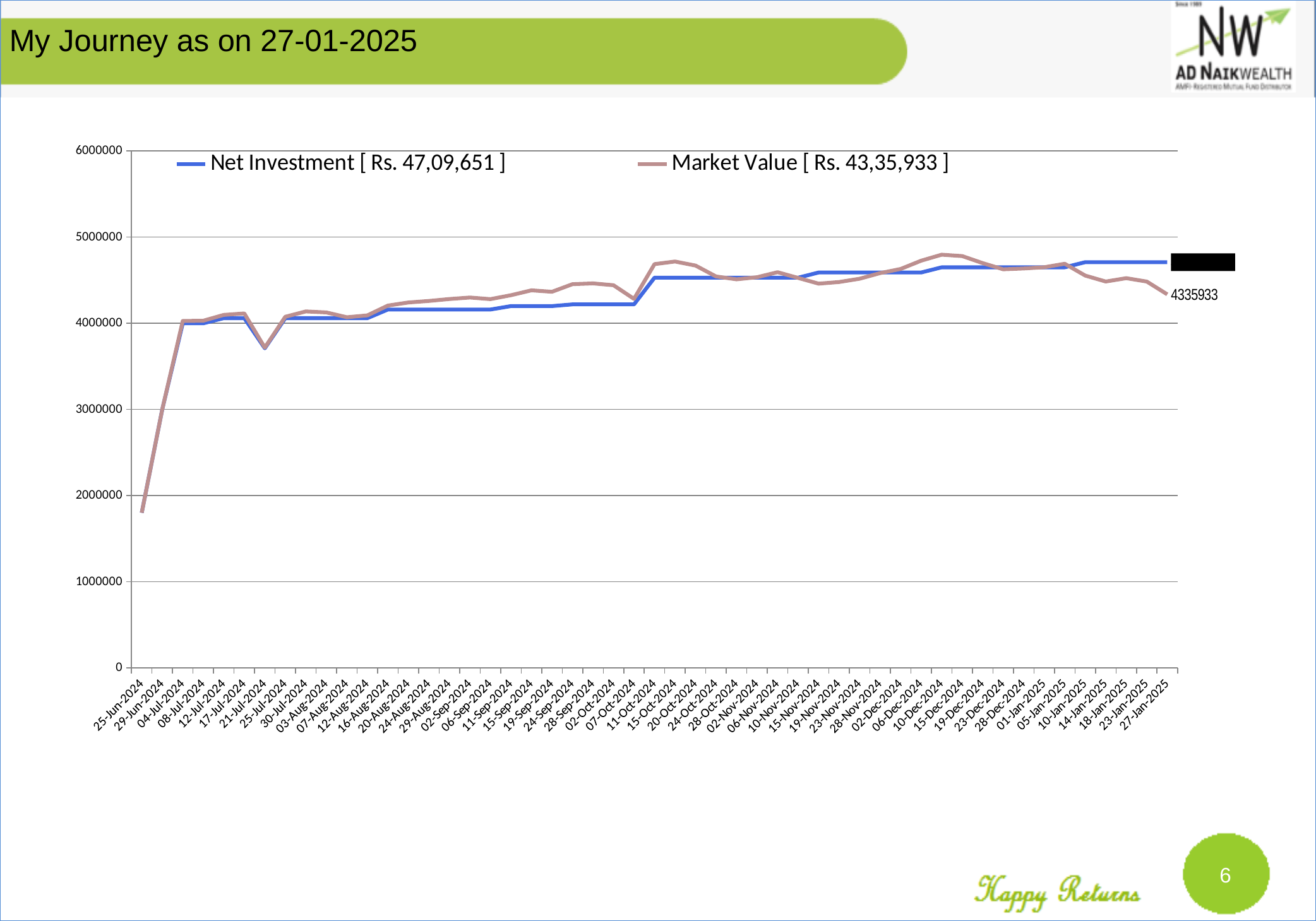
What is the difference between the Net Investment and the Market Value shown in the legend? Rs. 3,73,718 On 15-Oct-2024, which is larger: Net Investment or Market Value? Market Value Is the Market Value on 21-Jul-2024 greater or less than 4000000? less What are the two series named in the legend? Net Investment and Market Value Is the Market Value on 25-Jun-2024 greater or less than 2000000? less What kind of chart is shown on the slide? line chart What Net Investment amount is shown in the legend? Rs. 47,09,651 On 27-Jan-2025, which is larger: Net Investment or Market Value? Net Investment What is the Market Value on 27-Jan-2025 according to the data label? 4335933 How many series does the legend list? 2 What Market Value amount is shown in the legend? Rs. 43,35,933 Does the Net Investment line generally rise or fall from 25-Jun-2024 to 27-Jan-2025? rise